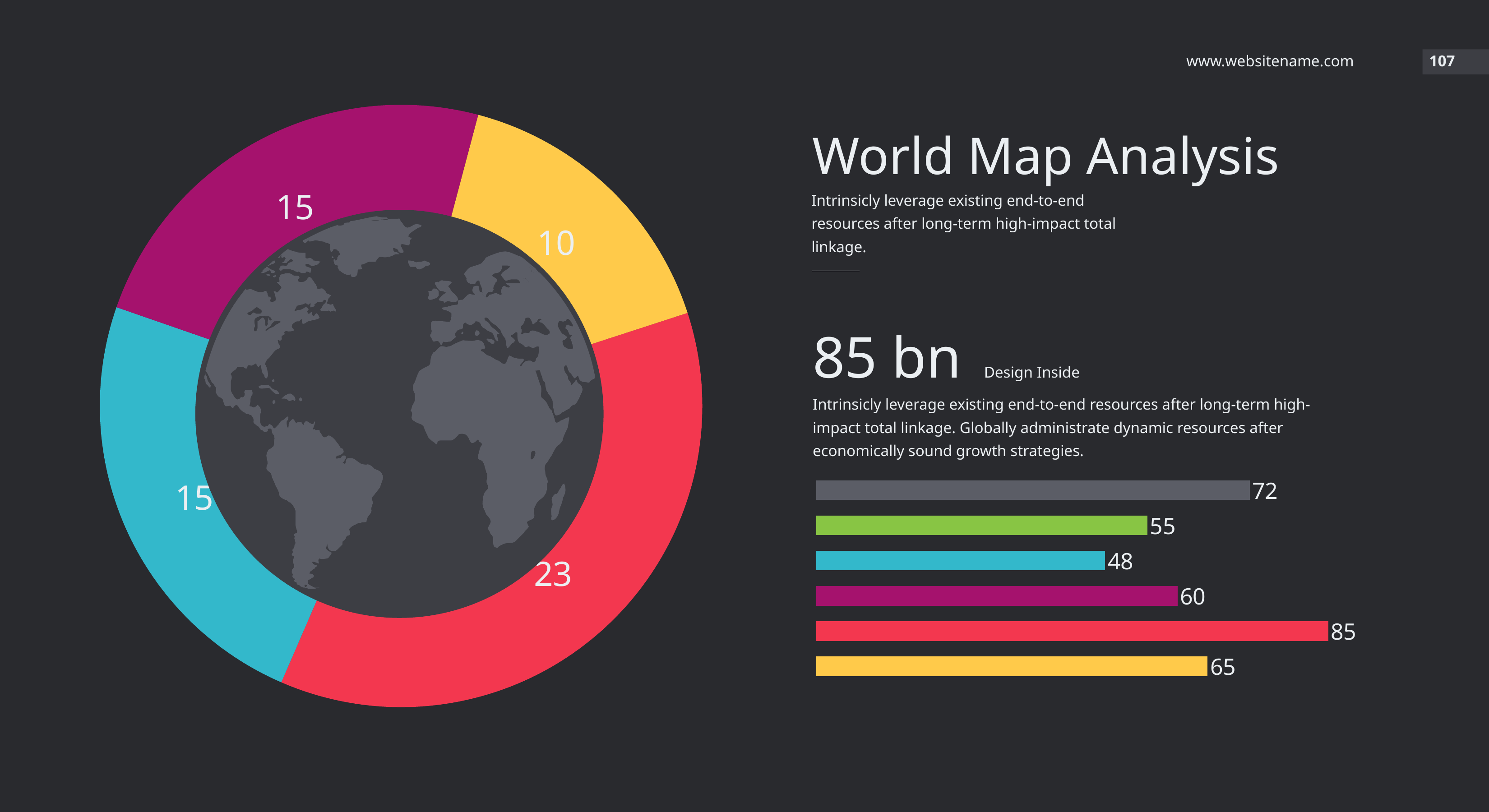
What kind of chart is on the left side of the slide? Donut chart In the bar chart on the right, what is the value of the top (grey) bar? 72 In the donut chart on the left, how many slices are there? 4 In the donut chart on the left, which slice has the largest value? The red slice (23) In the donut chart on the left, which slice has the smallest value? The yellow slice (10) In the bar chart on the right, how many bars are there? 6 In the donut chart on the left, what is the difference between the red slice and the yellow slice? 13 In the bar chart on the right, what is the difference between the highest bar (85) and the lowest bar (48)? 37 What kind of chart is on the right side of the slide, below the text? Bar chart In the bar chart on the right, which bar has the highest value? The red bar (85) In the donut chart on the left, what is the value of the yellow slice? 10 In the donut chart on the left, what is the value of the red slice? 23